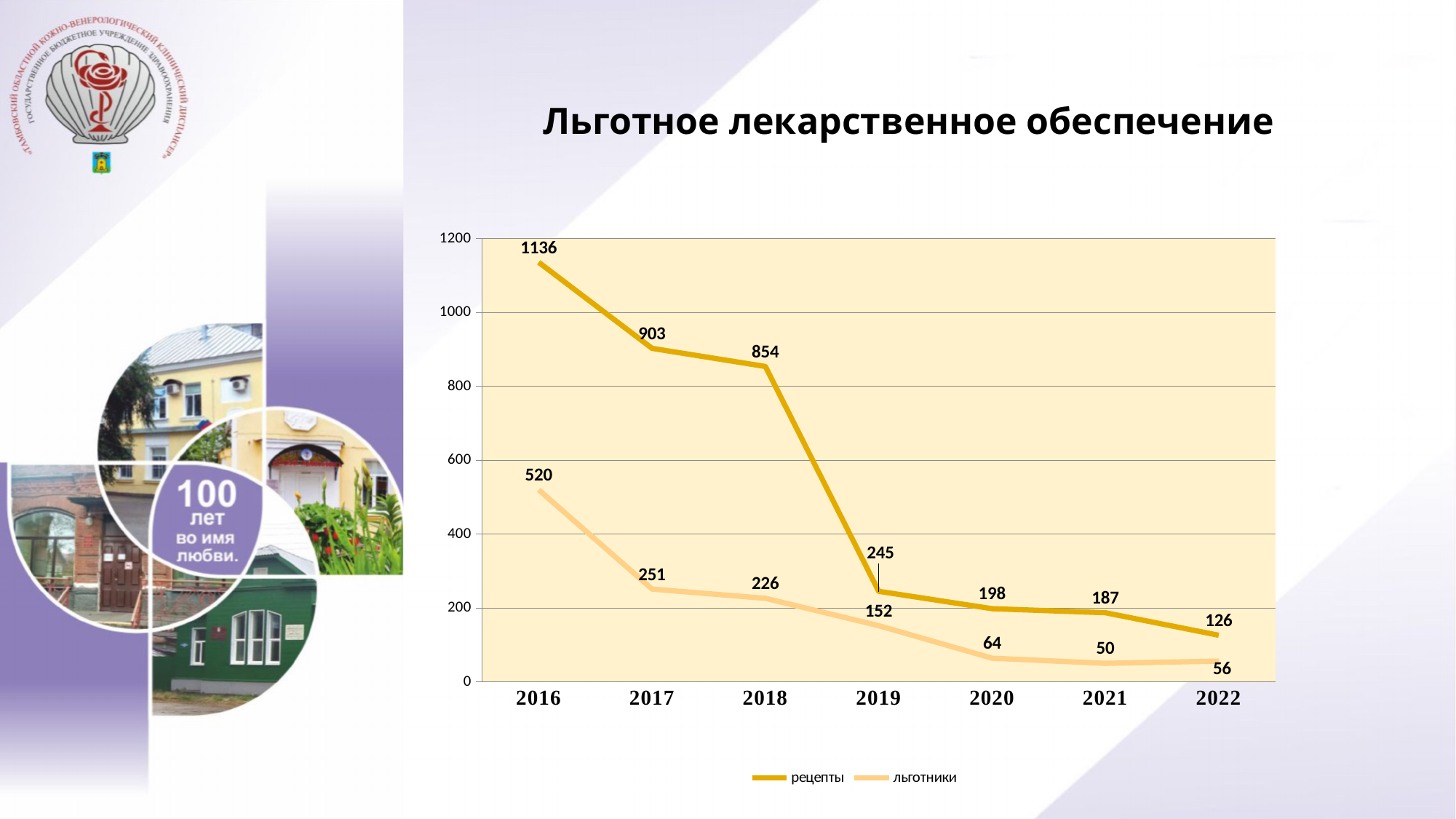
Does the value for рецепты rise or fall from 2016 to 2022? fall In which year is the value for льготники lowest? 2021 Which is larger in 2020: рецепты or льготники? рецепты What is the title of the chart? Льготное лекарственное обеспечение What type of chart is shown on the slide? line chart How many series does the legend list? 2 What is the difference between рецепты and льготники in 2018? 628 How many years are shown on the x axis? 7 What is the value for льготники in 2019? 152 What is the value for рецепты in 2022? 126 What is the value for рецепты in 2016? 1136 In which year is the value for рецепты highest? 2016